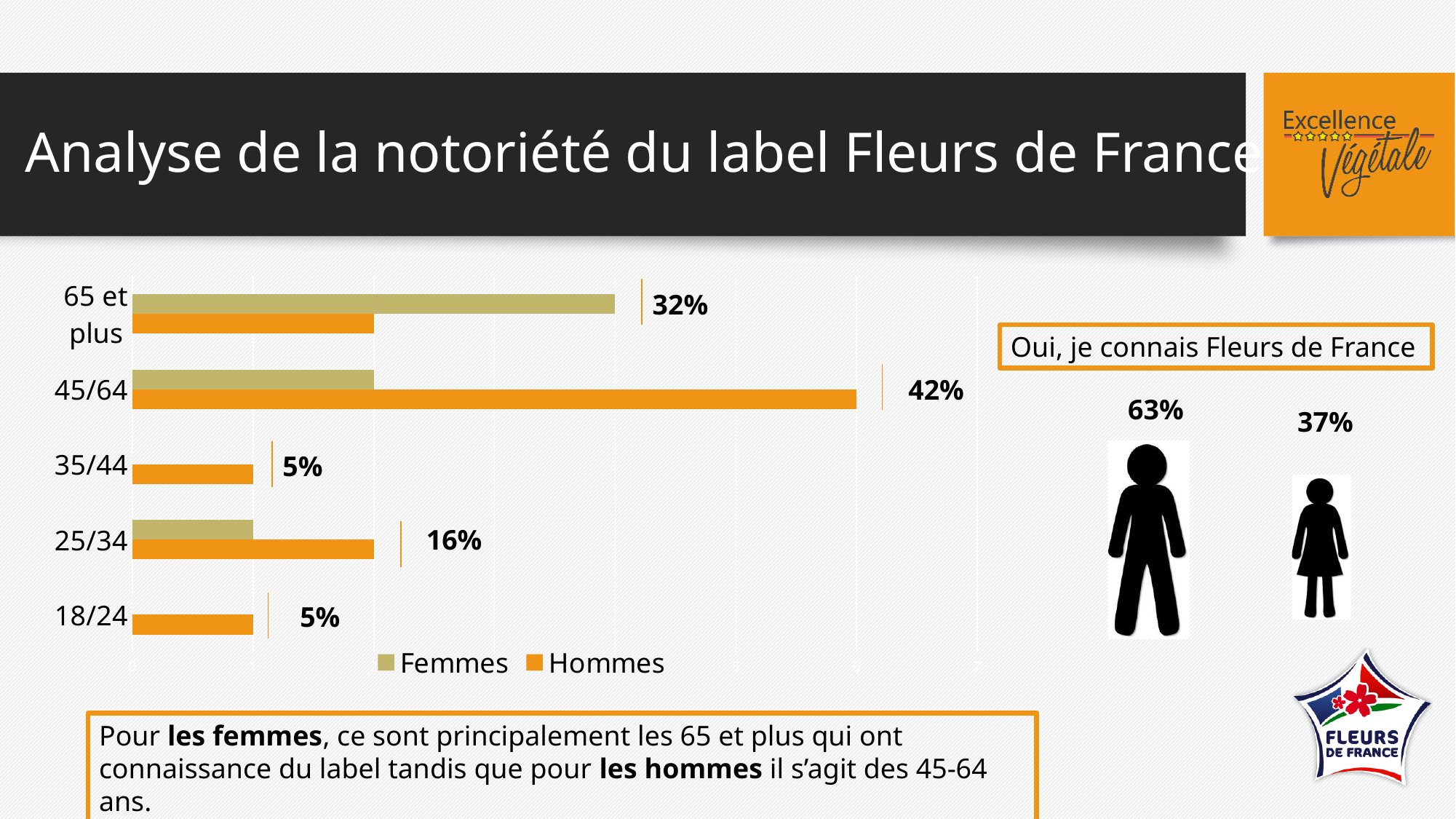
How many series does the legend of the bar chart list? 2 Which age group has the highest percentage label on the bar chart? 45/64 What percentage label is shown next to the 45/64 age group on the bar chart? 42% What is the difference between the percentage labels for 45/64 and '65 et plus' on the bar chart? 10% On the bar chart, for the '65 et plus' age group, which series has the longer bar, Femmes or Hommes? Femmes What are the two legend entries of the bar chart? Femmes, Hommes What percentage label is shown next to the '65 et plus' age group on the bar chart? 32% On the bar chart, is the Hommes bar longer for 45/64 or for '65 et plus'? 45/64 How many age categories are shown on the bar chart? 5 What kind of chart is shown on the left of the slide? bar chart What percentage label is shown next to the 25/34 age group on the bar chart? 16% What percentage is shown above the male figure on the right of the slide? 63%